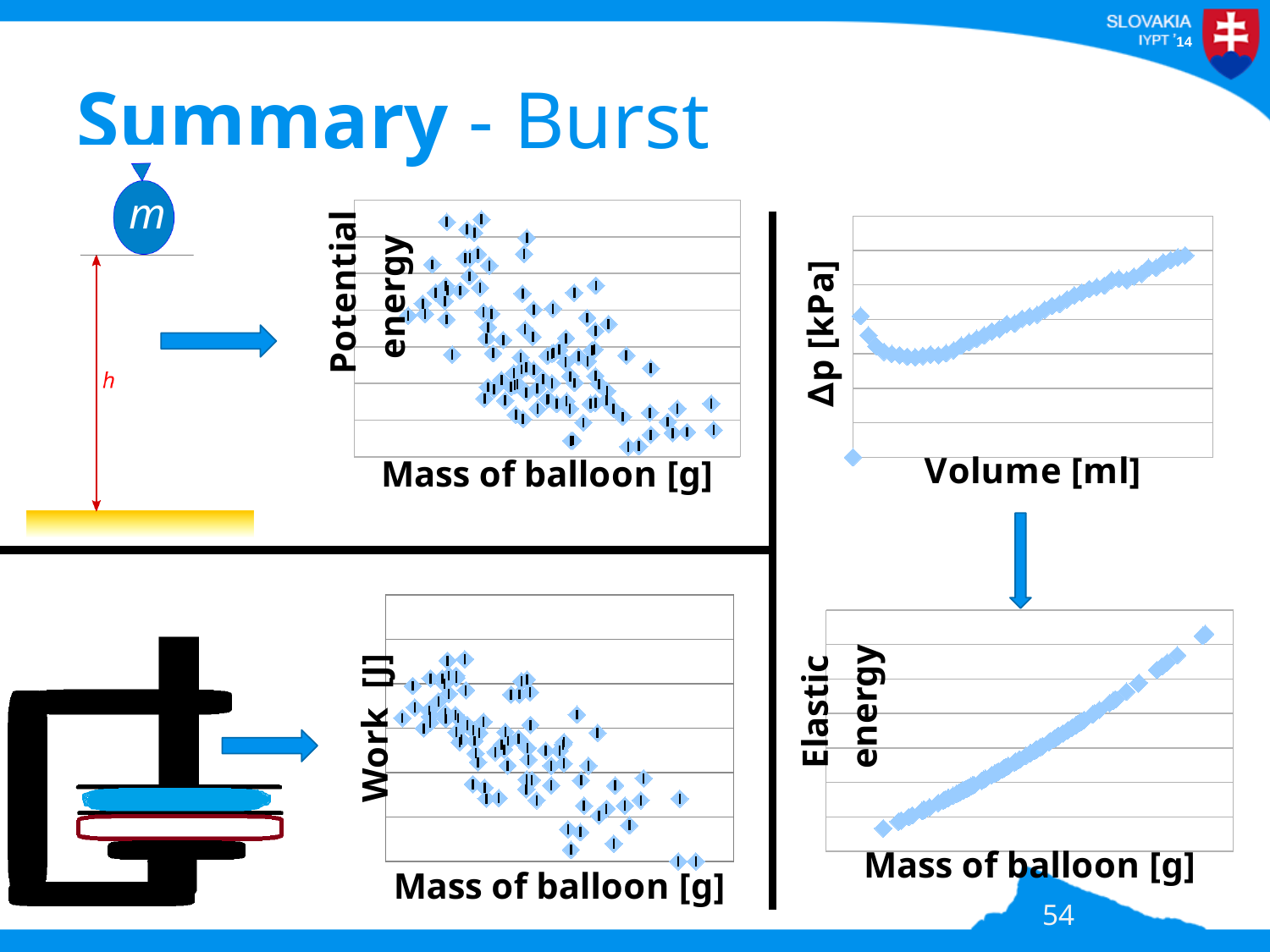
What kind of chart is the top-right chart with Δp [kPa] on the y axis? scatter chart What kind of chart is the top-left chart with Potential energy on the y axis? scatter chart What is the x-axis label of the top-right chart? Volume [ml] What is the y-axis label of the bottom-left chart? Work [J] What kind of chart is the bottom-right chart with Elastic energy on the y axis? scatter chart In the top-left chart, does Potential energy rise or fall as Mass of balloon [g] increases? fall In the top-right chart, does Δp [kPa] rise or fall over the right-hand portion of the Volume [ml] axis? rise In the bottom-right chart, does Elastic energy rise or fall as Mass of balloon [g] increases? rise